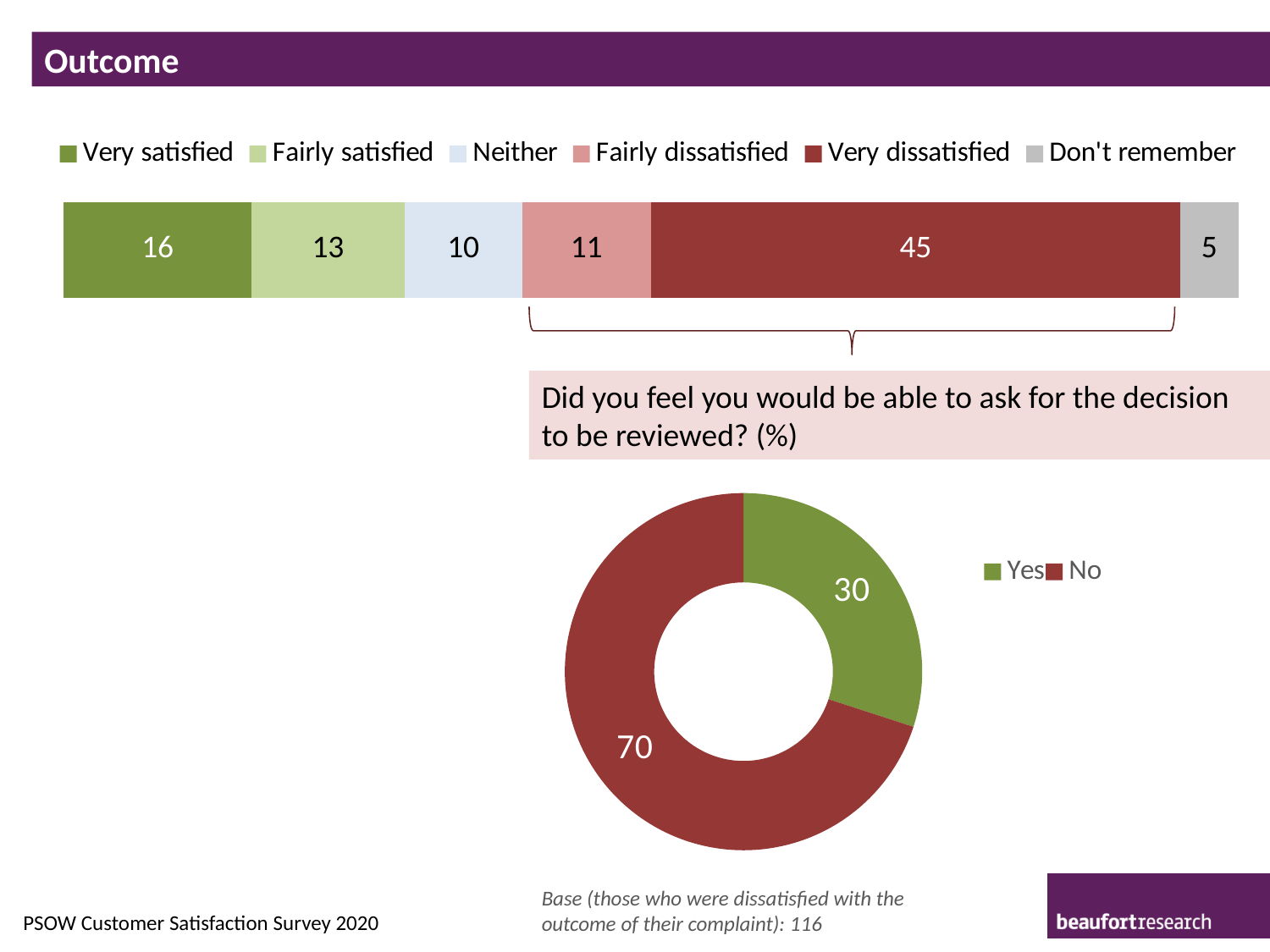
In the stacked bar chart at the top of the slide, which category has the highest value? Very dissatisfied In the doughnut chart 'Did you feel you would be able to ask for the decision to be reviewed? (%)', what is the value for No? 70 In the stacked bar chart at the top of the slide, what is the value for Fairly satisfied? 13 In the stacked bar chart at the top of the slide, what is the value for Very dissatisfied? 45 In the stacked bar chart at the top of the slide, which is larger, Fairly satisfied or Fairly dissatisfied? Fairly satisfied In the stacked bar chart at the top of the slide, what is the difference between Very dissatisfied and Very satisfied? 29 In the stacked bar chart at the top of the slide, which category has the lowest value? Don't remember In the doughnut chart 'Did you feel you would be able to ask for the decision to be reviewed? (%)', which is larger, Yes or No? No How many series does the legend of the stacked bar chart at the top of the slide list? 6 In the doughnut chart 'Did you feel you would be able to ask for the decision to be reviewed? (%)', what colour is the Yes slice? Green In the stacked bar chart at the top of the slide, what is the total of Fairly dissatisfied and Very dissatisfied combined? 56 What kind of chart is the chart titled 'Did you feel you would be able to ask for the decision to be reviewed? (%)'? Doughnut chart